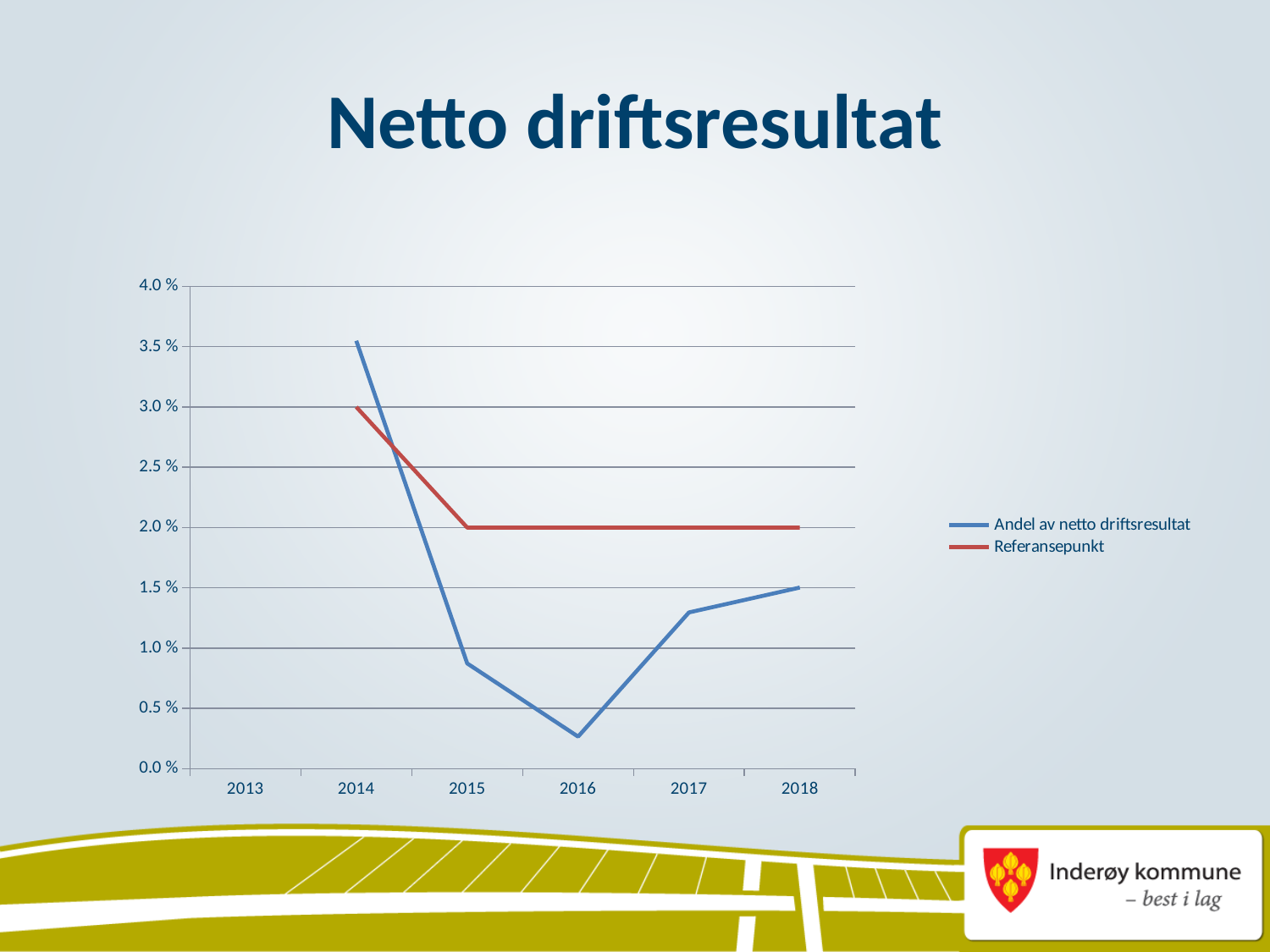
In 2017, which series has the higher value, Andel av netto driftsresultat or Referansepunkt? Referansepunkt How many series does the legend list? 2 What is the title of the chart? Netto driftsresultat In which year is Andel av netto driftsresultat highest? 2014 In which year is Andel av netto driftsresultat lowest? 2016 What kind of chart is shown on the slide? Line chart Does Andel av netto driftsresultat rise or fall from 2016 to 2018? Rise Which series is drawn in red? Referansepunkt What is the value of Referansepunkt in 2016? 2.0 % Is the value for Andel av netto driftsresultat in 2016 greater or less than 0.5 %? less What is the value of Referansepunkt in 2014? 3.0 % Is the value for Andel av netto driftsresultat in 2014 greater or less than 3.0 %? greater